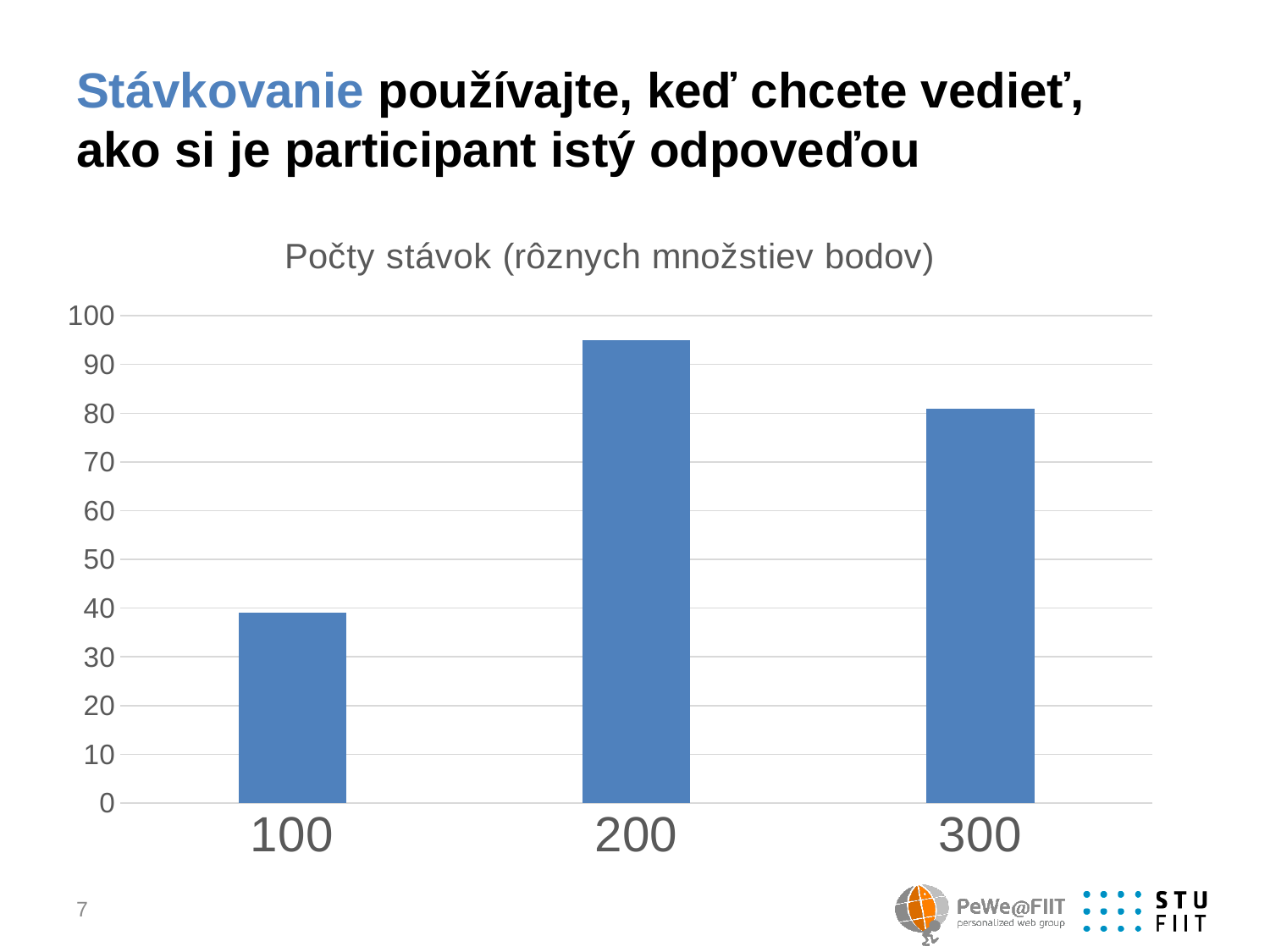
Which is larger, the value for 100 or the value for 300? 300 Which category has the lowest bar in the chart? 100 Which category has the highest bar in the chart? 200 Is the value for 300 greater or less than 70? greater Is the value for 300 greater or less than 90? less Is the value for 100 greater or less than 50? less What kind of chart is shown on the slide? bar chart How many categories are shown on the x axis of the chart? 3 What is the title of the chart? Počty stávok (rôznych množstiev bodov) Which is larger, the value for 200 or the value for 300? 200